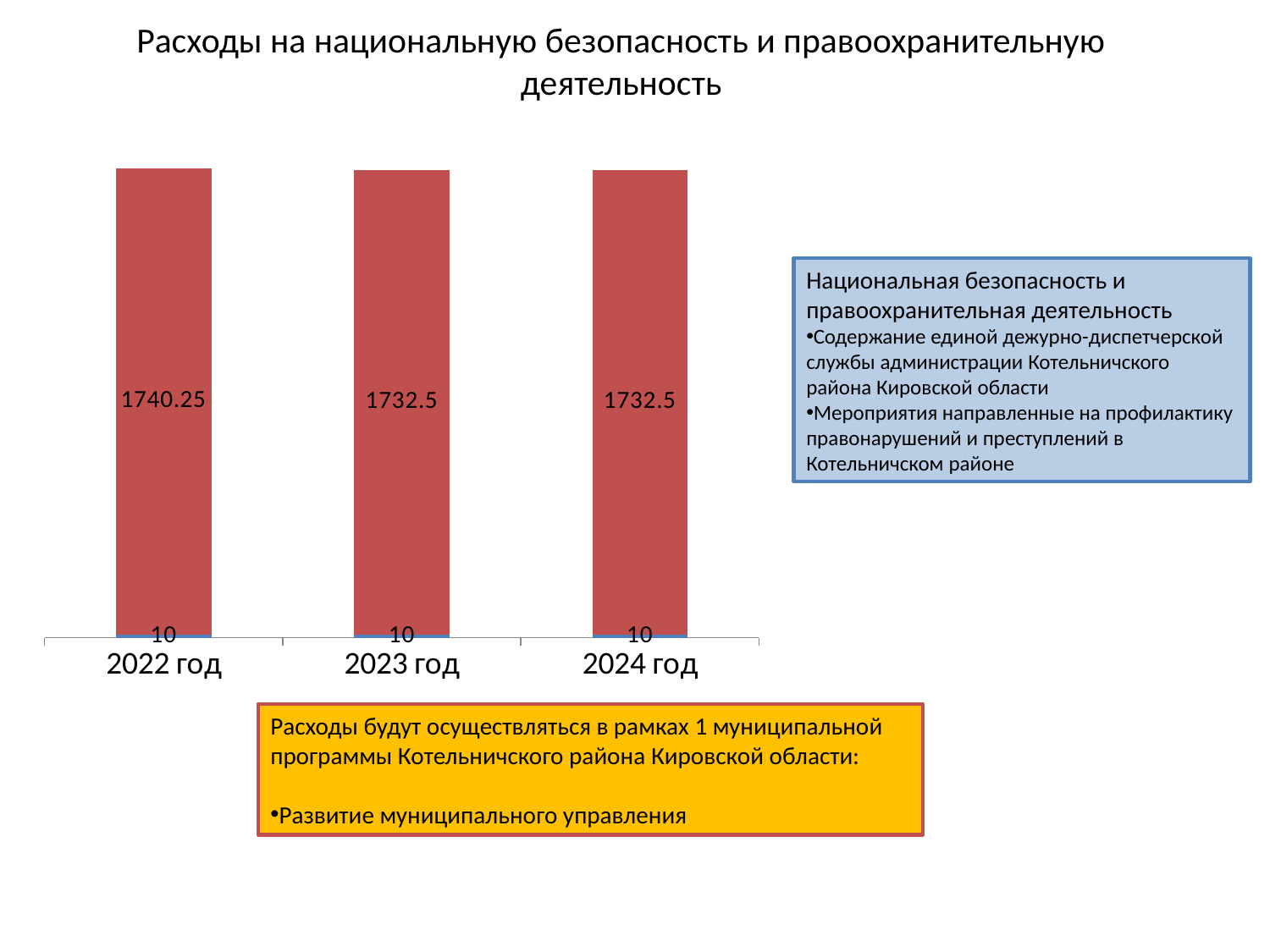
What is the title of the chart? Расходы на национальную безопасность и правоохранительную деятельность How many years are shown on the x axis? 3 What is the difference between the red segment values for 2022 год and 2023 год? 7.75 Which year has the highest value for the red segment? 2022 год Does the red segment value rise or fall from 2022 год to 2023 год? Fall What is the value of the red segment for 2022 год? 1740.25 What is the total of the stacked bar for 2024 год? 1742.5 What is the value of the red segment for 2024 год? 1732.5 What kind of chart is shown on the slide? Stacked bar chart What is the total of the stacked bar for 2022 год? 1750.25 What is the value of the red segment for 2023 год? 1732.5 What is the value of the small blue segment for 2022 год? 10